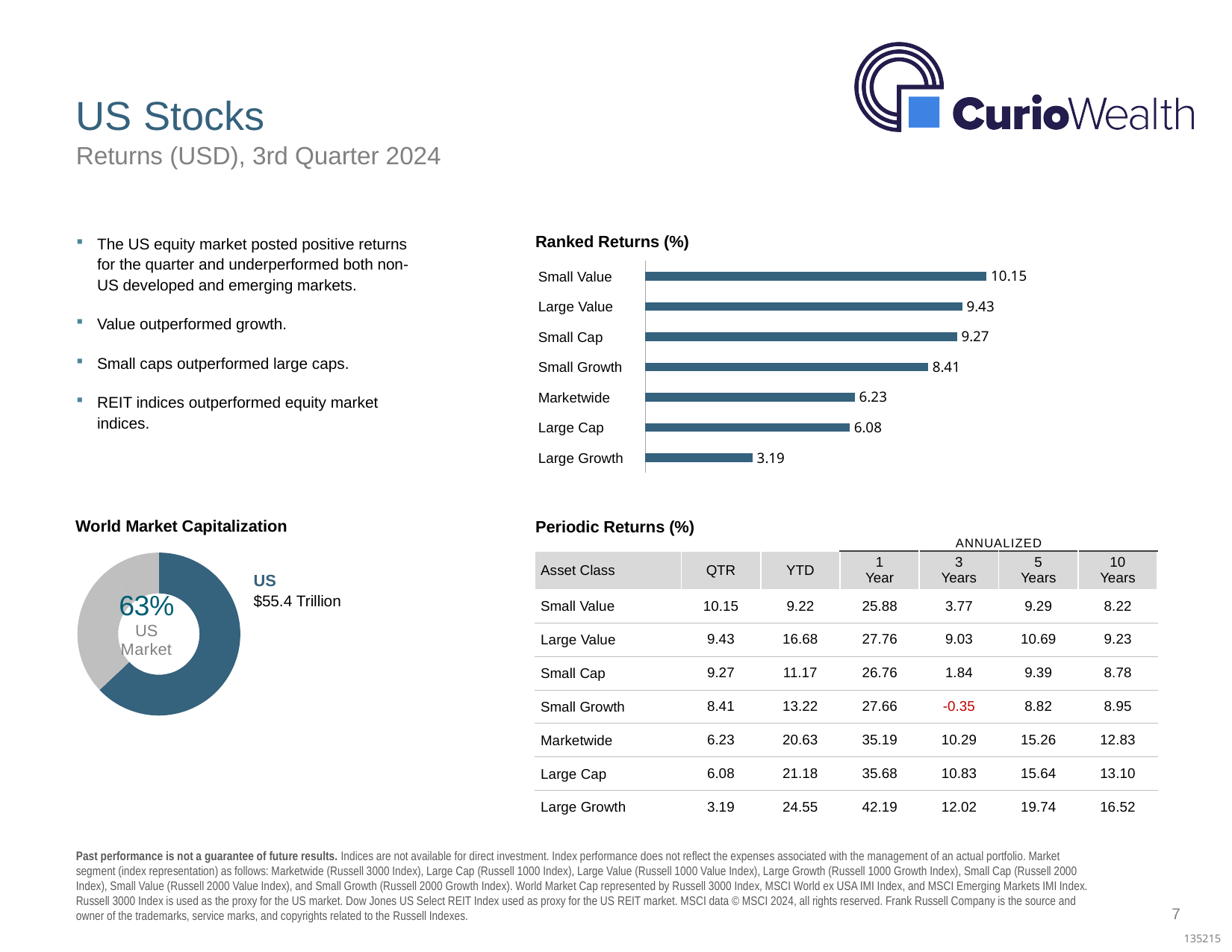
In the Ranked Returns (%) chart, what is the difference between Large Value and Small Cap? 0.16 In the Ranked Returns (%) chart, what is the value for Marketwide? 6.23 In the World Market Capitalization chart, what is the US market capitalization in dollars? $55.4 Trillion What type of chart is the Ranked Returns (%) chart? Bar chart In the Ranked Returns (%) chart, which is larger, Small Growth or Large Cap? Small Growth In the World Market Capitalization chart, what share of the world market does the US represent? 63% In the Ranked Returns (%) chart, what is the value for Small Value? 10.15 In the Ranked Returns (%) chart, what is the value for Large Growth? 3.19 How many categories are shown in the Ranked Returns (%) chart? 7 In the Ranked Returns (%) chart, which category has the lowest value? Large Growth In the Ranked Returns (%) chart, what is the difference between Small Value and Large Growth? 6.96 In the Ranked Returns (%) chart, which category has the highest value? Small Value